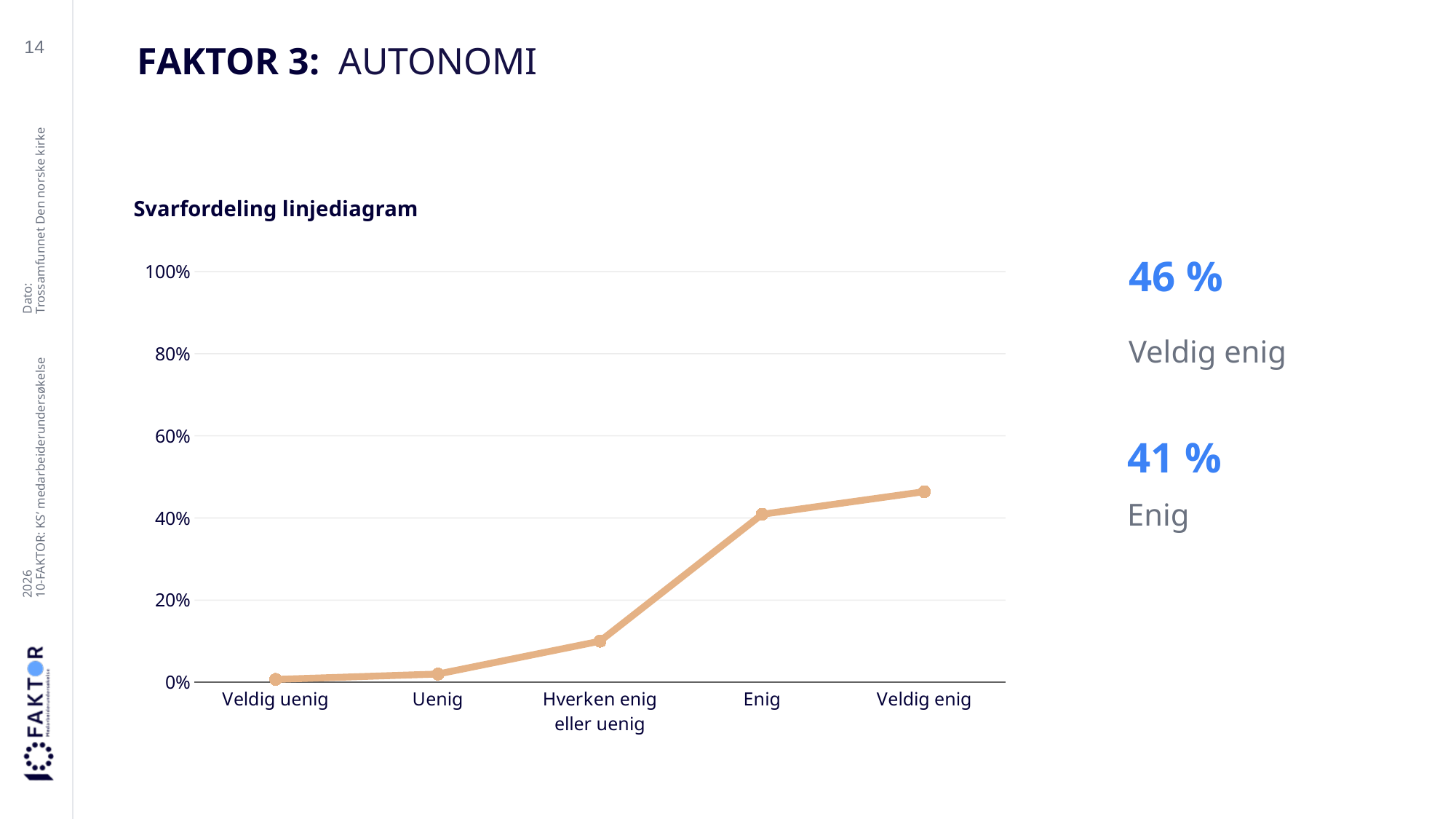
Do the values rise or fall from Veldig uenig to Veldig enig? rise Which is larger, the value for Enig or the value for Veldig enig? Veldig enig What is the value for Enig? 41 % Is the value for Hverken enig eller uenig greater or less than 20%? less Is the value for Enig greater or less than 60%? less Which category has the lowest value? Veldig uenig Is the value for Uenig greater or less than 20%? less How many categories are shown on the x axis? 5 What is the difference between the values for Veldig enig and Enig? 5 % Which category has the highest value? Veldig enig What is the value for Veldig enig? 46 % What kind of chart is shown on the slide? line chart